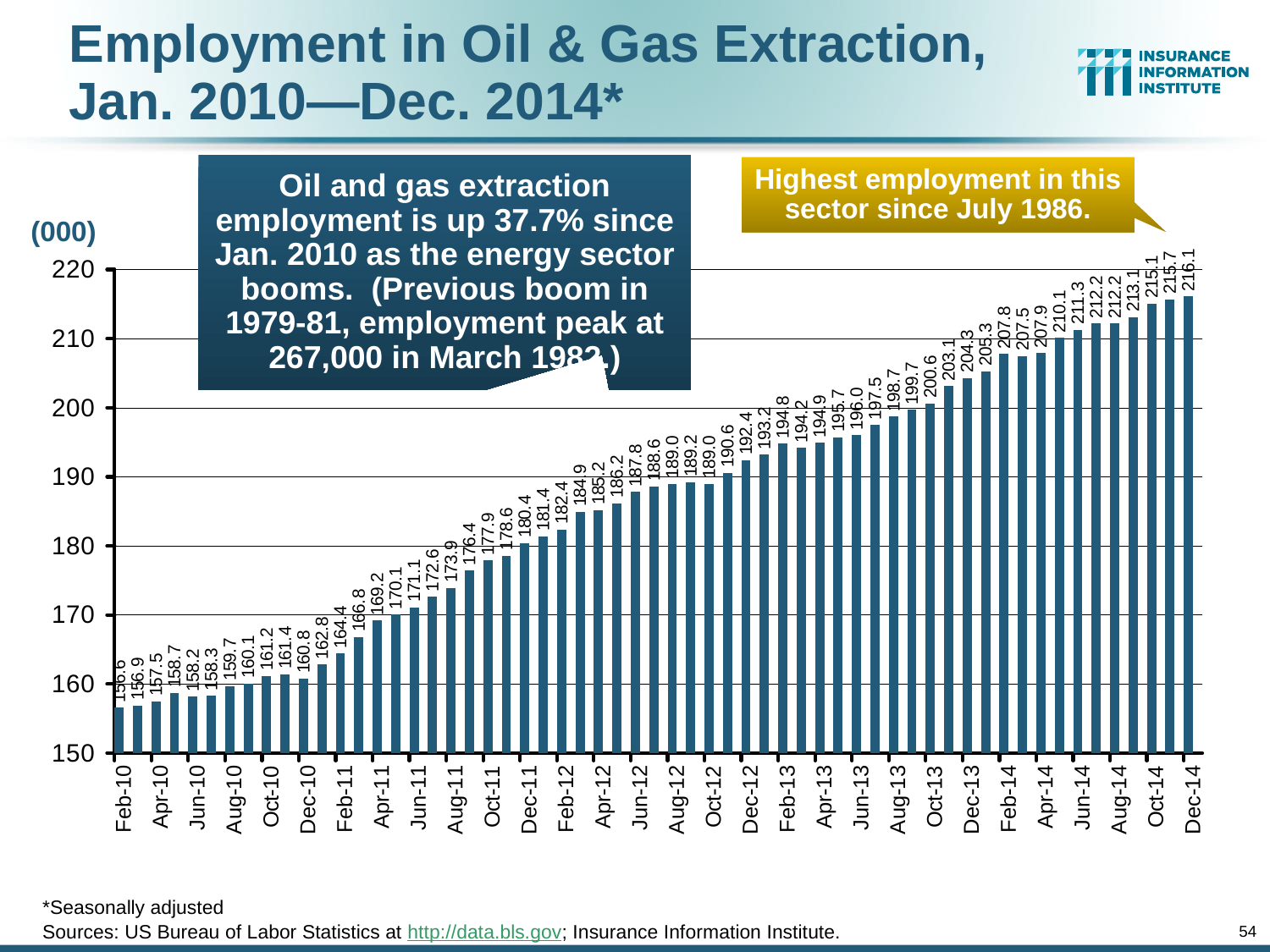
What is the employment value for Oct-13? 200.6 Do the employment values generally rise or fall from left to right across the chart? Rise What is the difference between the Dec-14 value and the Dec-13 value? 11.8 What type of chart is shown on the slide? Bar chart What is the employment value for Dec-14? 216.1 Which is larger, the value for Dec-12 or the value for Dec-11? Dec-12 Which month has the highest employment value in the chart? Dec-14 What is the employment value for Dec-13? 204.3 What unit label is shown above the vertical axis? (000) Is the value for Dec-11 greater or less than 190? less What is the employment value for Dec-12? 192.4 What is the employment value for Oct-14? 215.1